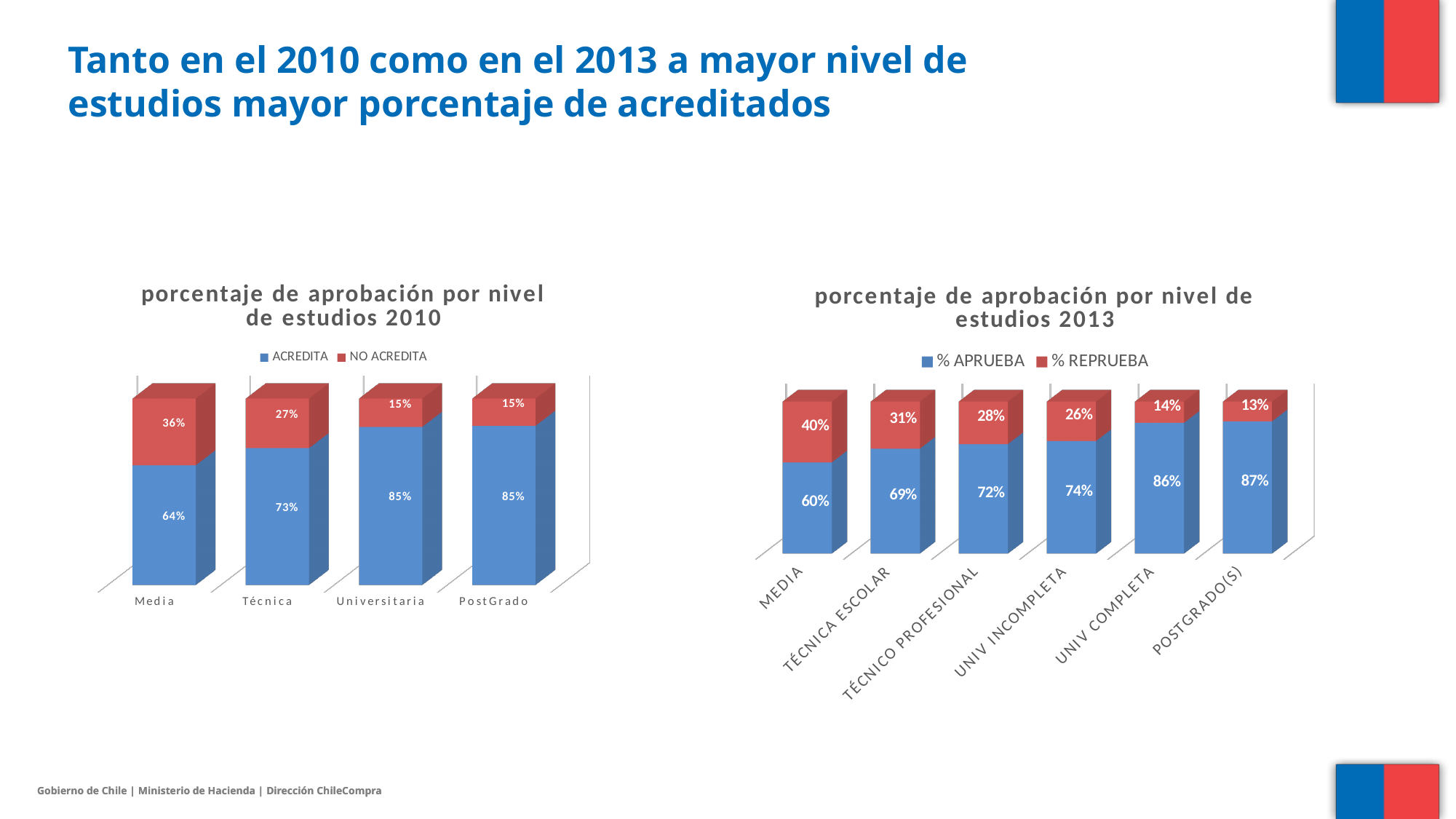
In the 2010 chart, which category has the lowest ACREDITA value? Media In the 2013 chart, is the % APRUEBA value larger for MEDIA or for TÉCNICA ESCOLAR? TÉCNICA ESCOLAR In the 2010 chart (porcentaje de aprobación por nivel de estudios 2010), what is the ACREDITA value for Técnica? 73% In the 2010 chart, how many categories are shown on the x axis? 4 In the 2013 chart, what is the % REPRUEBA value for TÉCNICO PROFESIONAL? 28% What kind of chart is the 2013 chart? Stacked bar chart In the 2013 chart, how many categories are shown on the x axis? 6 In the 2013 chart, how many series does the legend list? 2 In the 2013 chart, which category has the highest % APRUEBA value? POSTGRADO(S) In the 2013 chart (porcentaje de aprobación por nivel de estudios 2013), what is the % APRUEBA value for UNIV INCOMPLETA? 74% In the 2010 chart, what is the difference between the ACREDITA values for Universitaria and Media? 21% In the 2010 chart, what is the NO ACREDITA value for Media? 36%